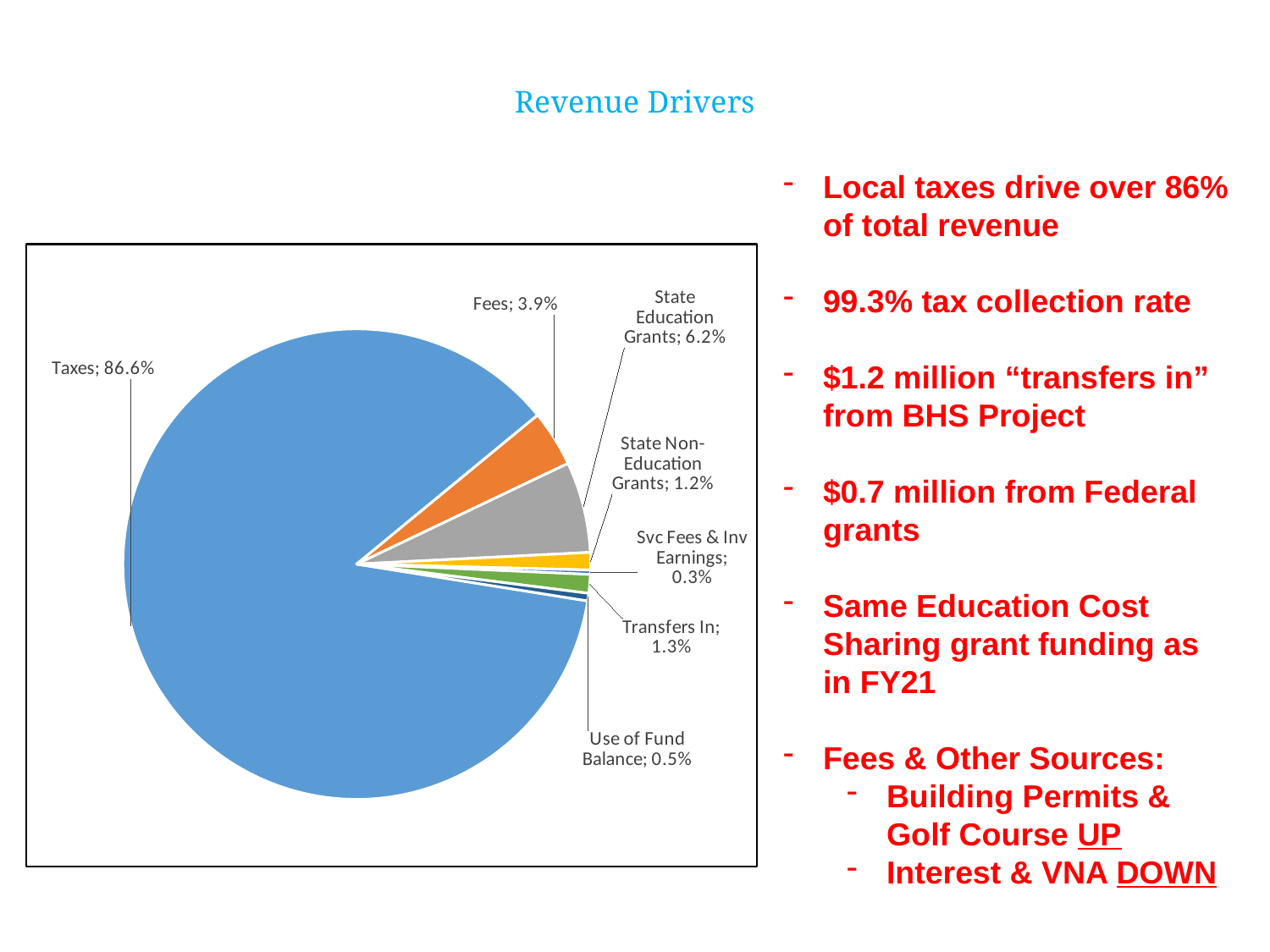
What share of the pie is Transfers In? 1.3% What is the difference in percentage points between State Education Grants and State Non-Education Grants? 5.0% What is the title of the slide containing the pie chart? Revenue Drivers What share of the pie is Fees? 3.9% Which slice of the pie is the largest? Taxes What share of the pie is Svc Fees & Inv Earnings? 0.3% How many slices does the pie chart have? 7 Which is larger, State Education Grants or Fees? State Education Grants What type of chart is shown on the slide? pie chart What share of the pie is Taxes? 86.6% Which slice of the pie is the smallest? Svc Fees & Inv Earnings What share of the pie is State Education Grants? 6.2%